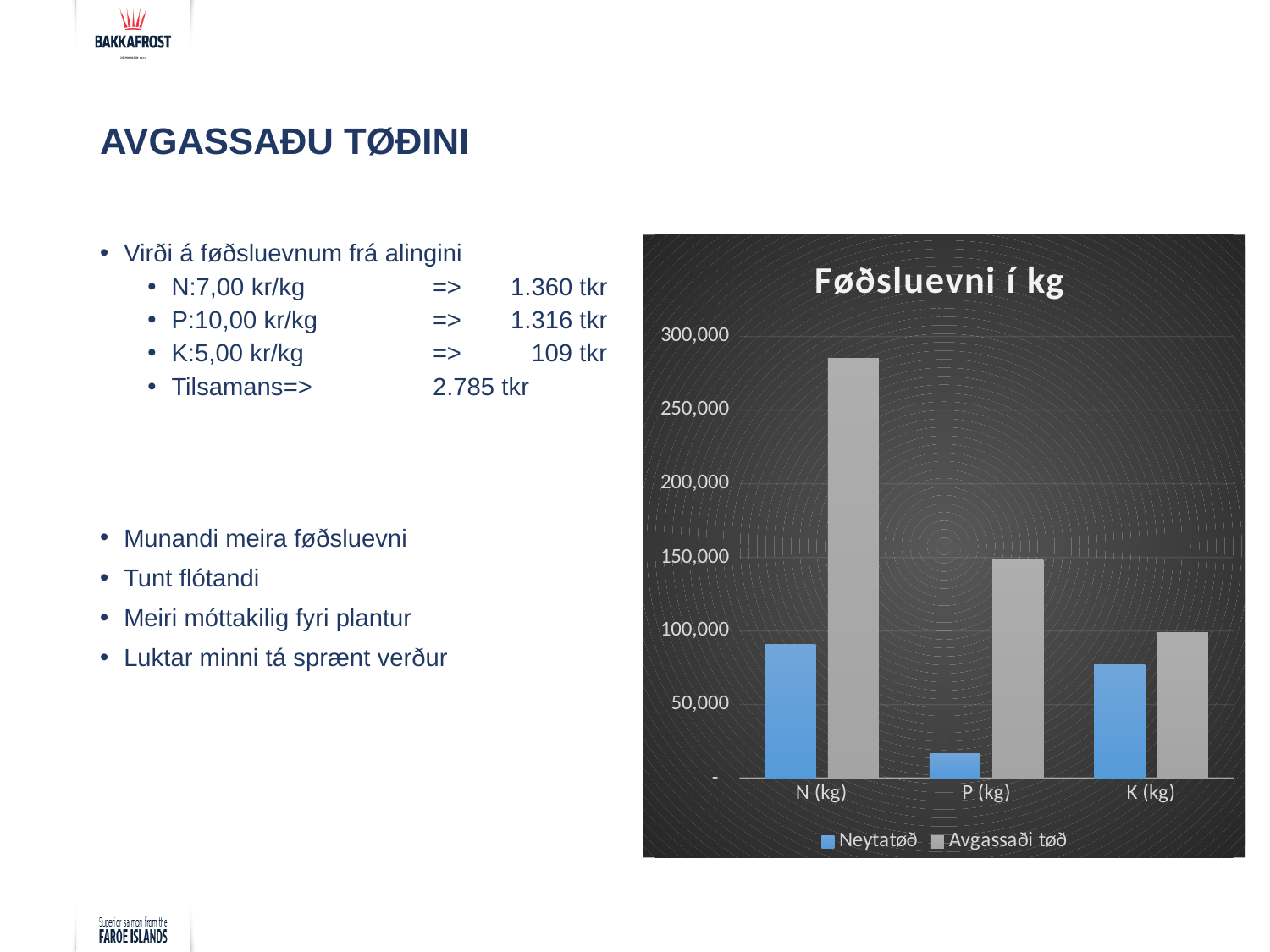
How many categories are shown on the x axis of the chart? 3 What is the title of the chart? Føðsluevni í kg How many series does the chart legend list? 2 Is the Avgassaði tøð value for N (kg) greater or less than 250,000? greater For which category is the Avgassaði tøð value highest? N (kg) For which category is the Avgassaði tøð value lowest? K (kg) For K (kg), which series has the larger value, Neytatøð or Avgassaði tøð? Avgassaði tøð Is the Neytatøð value for P (kg) greater or less than 50,000? less For which category is the Neytatøð value lowest? P (kg) Is the Neytatøð value for K (kg) greater or less than 100,000? less What type of chart is shown on the slide? bar chart Which series is shown in blue in the chart? Neytatøð